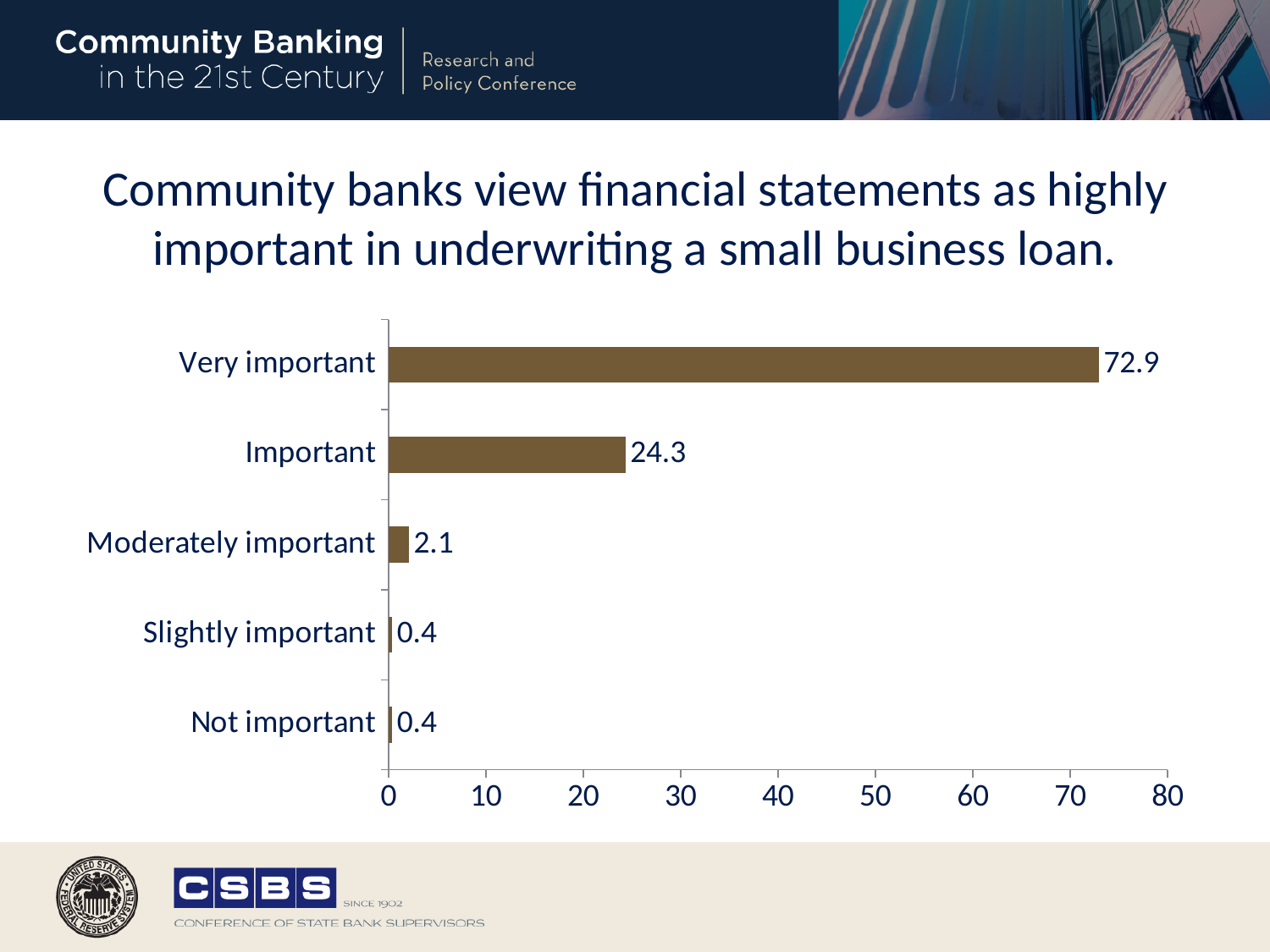
What kind of chart is shown on the slide? bar chart What is the value for Very important? 72.9 Which category has the highest value? Very important Which is larger, the value for Important or the value for Moderately important? Important What is the value for Not important? 0.4 What is the maximum value shown on the horizontal axis? 80 What is the difference between the values for Very important and Important? 48.6 How many categories are shown in the chart? 5 What is the value for Moderately important? 2.1 Is the value for Very important greater or less than 70? greater Do the values for Slightly important and Not important have the same value? Yes What is the value for Important? 24.3